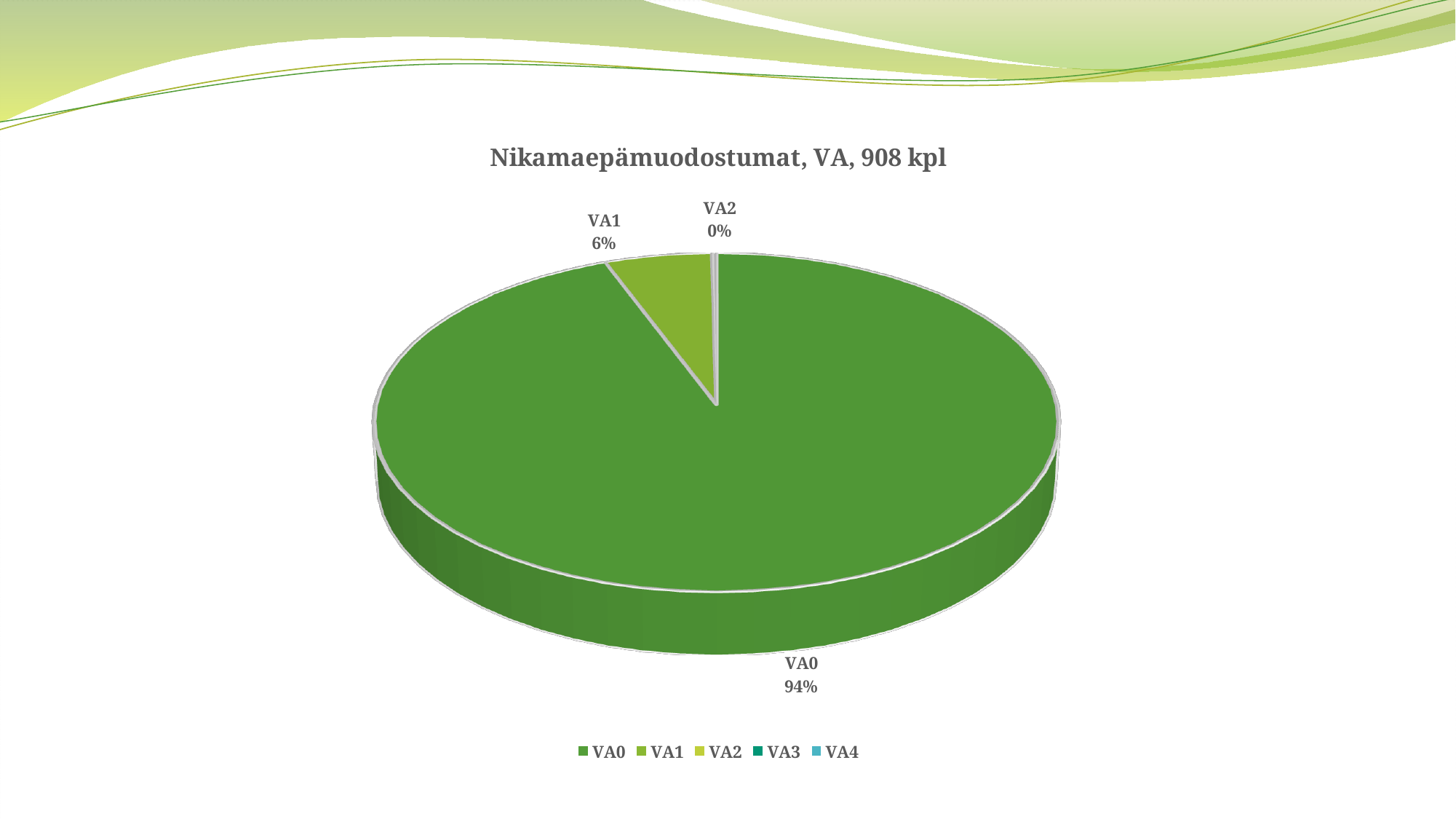
What share of the pie does VA0 have? 94% What is the difference in percentage points between the VA0 and VA1 shares? 88 What kind of chart is shown on the slide? pie chart Which of VA0 and VA1 has the larger share? VA0 How many categories does the legend list? 5 Which category has the largest slice of the pie? VA0 Which legend entries are listed after VA2? VA3 and VA4 What share of the pie does VA1 have? 6% How many slices have a percentage label printed on the chart? 3 What is the title of the chart? Nikamaepämuodostumat, VA, 908 kpl Is the share for VA1 greater or less than 50%? less What share of the pie does VA2 have? 0%